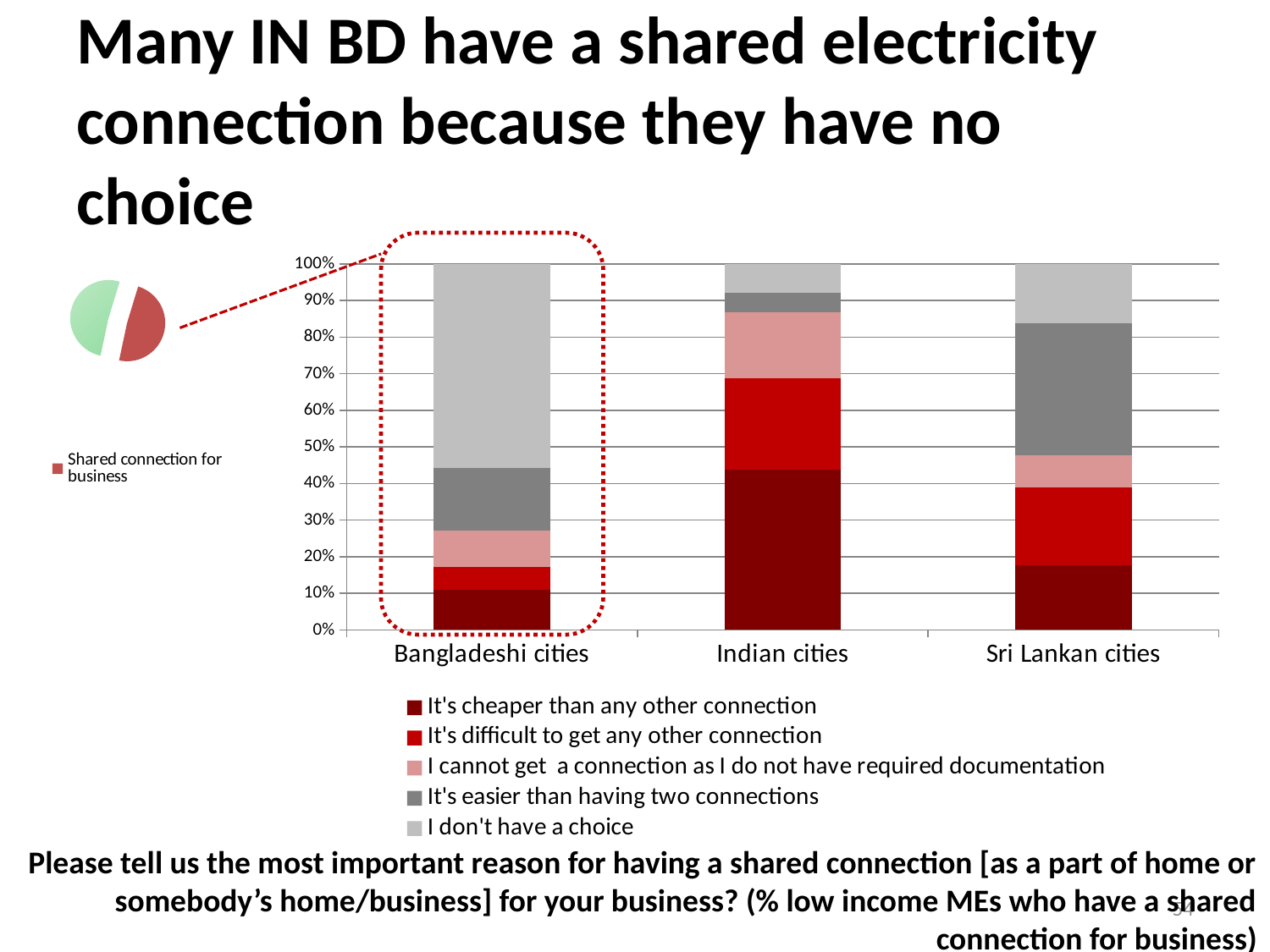
Which city category has the largest share for 'I don't have a choice'? Bangladeshi cities What is the last entry listed in the legend of the stacked bar chart? I don't have a choice Which is larger: the share for 'It's cheaper than any other connection' in Indian cities or in Bangladeshi cities? Indian cities How many city categories are shown on the x axis of the stacked bar chart? 3 Is the share for 'It's cheaper than any other connection' in Bangladeshi cities greater or less than 20%? less Is the share for 'It's easier than having two connections' in Sri Lankan cities greater or less than 30%? greater What is the total of the stacked bar for Indian cities? 100% Is the share for 'I don't have a choice' in Bangladeshi cities greater or less than 50%? greater How many series does the legend of the stacked bar chart list? 5 Which city category has the largest share for 'It's cheaper than any other connection'? Indian cities Which city category has the smallest share for 'It's easier than having two connections'? Indian cities What kind of chart is the main chart on the slide? stacked bar chart